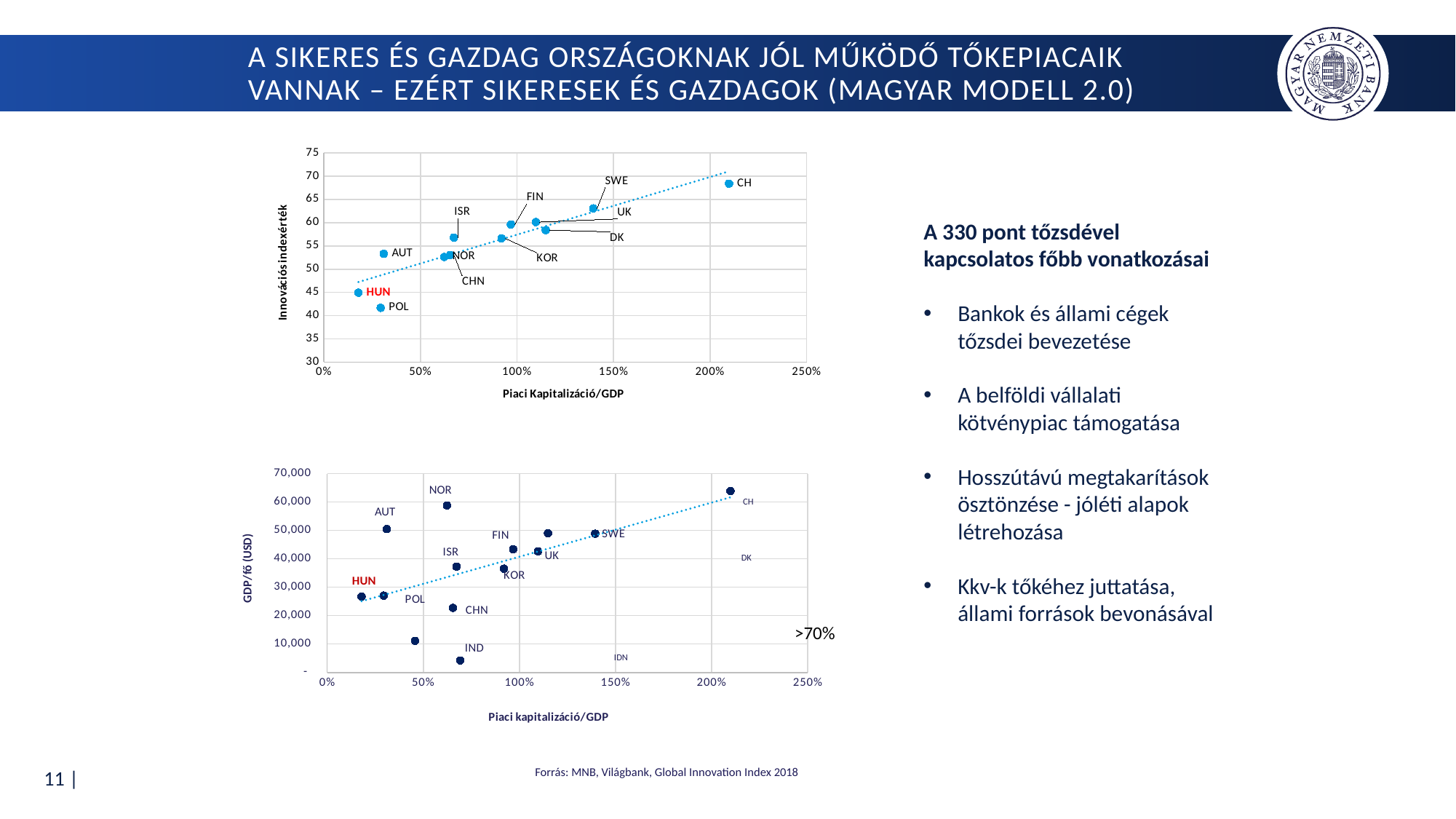
In the top chart, which has the higher innovation index value, AUT or POL? AUT In the bottom chart, is the GDP per capita for NOR greater or less than 50,000? greater In the top chart, is the innovation index value for HUN greater or less than 50? less How many country points are plotted in the top chart? 12 In the top chart, do the innovation index values generally rise or fall as market capitalisation/GDP increases? rise What is the y-axis title of the bottom chart? GDP/fő (USD) In the top chart (Innovációs indexérték), which country has the highest innovation index value? CH In the bottom chart (GDP/fő), which country has the highest GDP per capita? CH In the top chart, is the innovation index value for CH greater or less than 65? greater In the bottom chart (GDP/fő), which labelled country has the lowest GDP per capita? IND What kind of chart is the top chart on the slide? scatter chart In the top chart (Innovációs indexérték), which country has the lowest innovation index value? POL